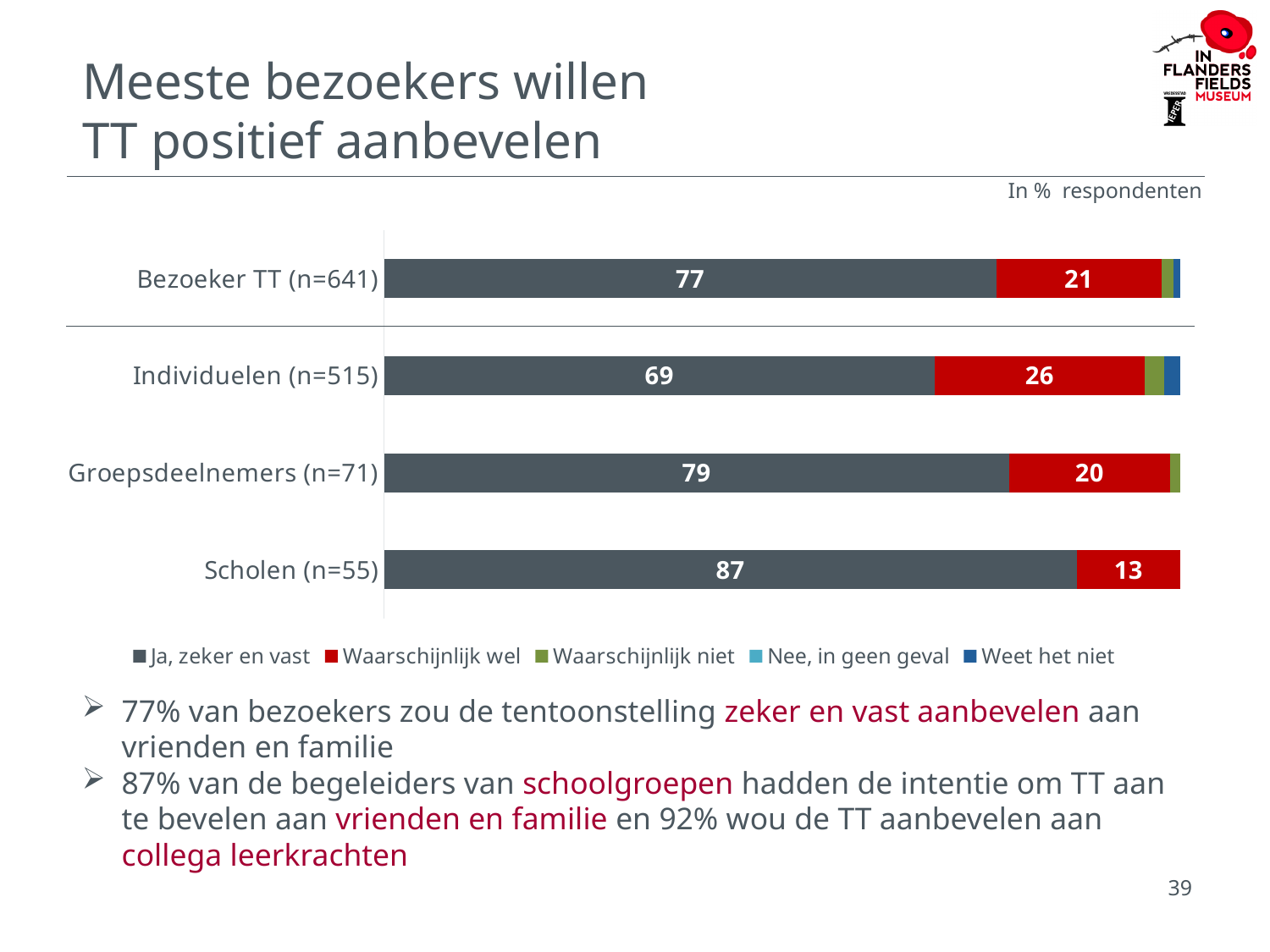
Which category has the lowest value for 'Ja, zeker en vast'? Individuelen (n=515) How many categories are shown on the chart? 4 What is the value of 'Waarschijnlijk wel' for Individuelen (n=515)? 26 What is the value of 'Waarschijnlijk wel' for Groepsdeelnemers (n=71)? 20 What is the value of 'Ja, zeker en vast' for Scholen (n=55)? 87 Which category has the highest value for 'Ja, zeker en vast'? Scholen (n=55) How many series does the legend list? 5 Which is larger: the 'Waarschijnlijk wel' value for Individuelen (n=515) or for Scholen (n=55)? Individuelen (n=515) What is the value of 'Ja, zeker en vast' for Bezoeker TT (n=641)? 77 What kind of chart is shown on the slide? Stacked bar chart What is the difference between the 'Ja, zeker en vast' values for Scholen (n=55) and Individuelen (n=515)? 18 What is the total of the printed values in the Scholen (n=55) bar? 100